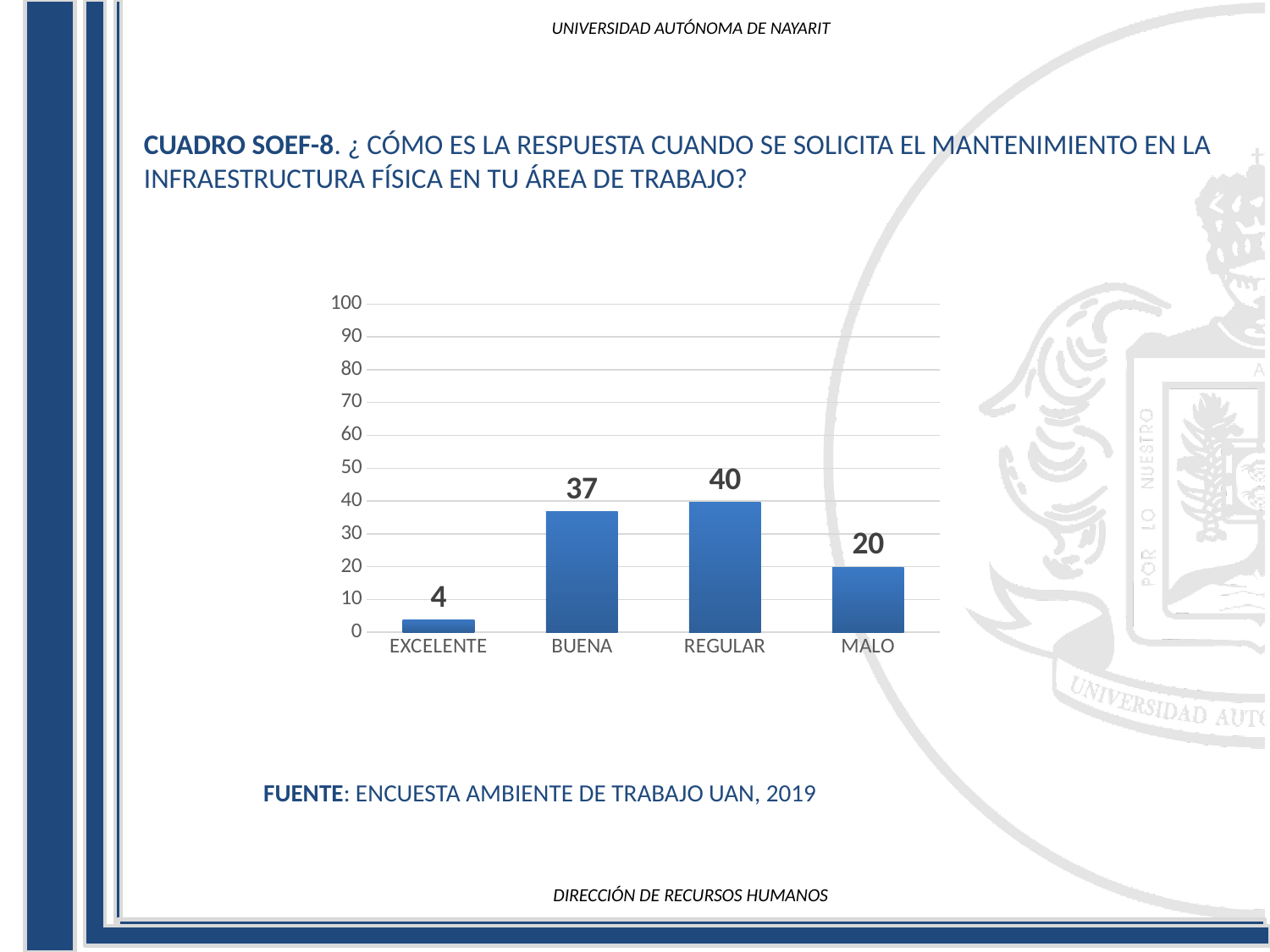
What kind of chart is shown on the slide? bar chart Is the value for REGULAR greater or less than 50? less What is the difference between the values for REGULAR and MALO? 20 What is the value for MALO? 20 How many categories are shown on the x axis? 4 What is the difference between the values for BUENA and EXCELENTE? 33 Which category has the highest value? REGULAR What is the source cited below the chart? ENCUESTA AMBIENTE DE TRABAJO UAN, 2019 What is the value for BUENA? 37 Which category has the lowest value? EXCELENTE What is the value for EXCELENTE? 4 Which is larger, the value for BUENA or the value for MALO? BUENA